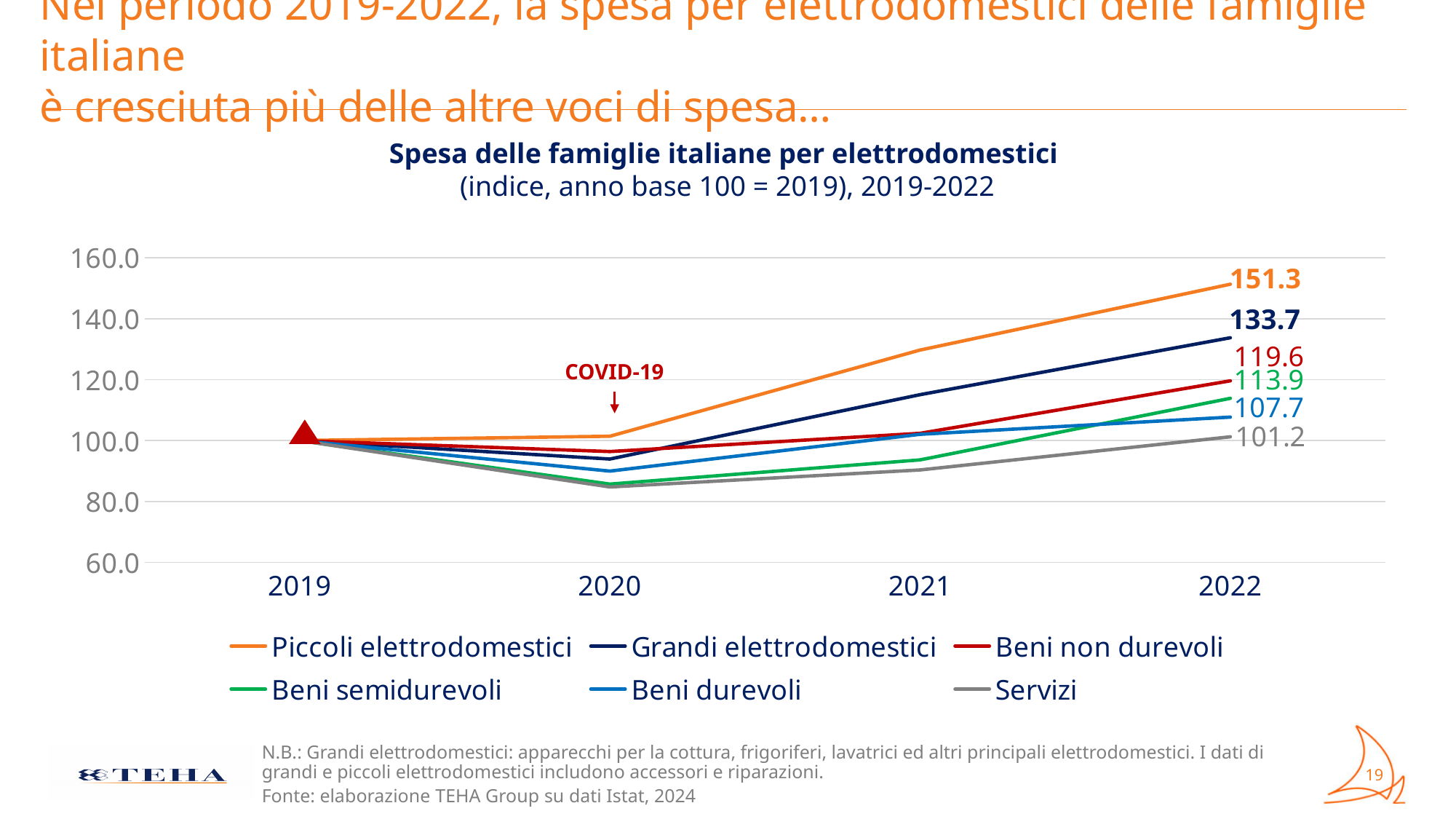
What is the index value for Grandi elettrodomestici in 2022? 133.7 What is the index value for Piccoli elettrodomestici in 2022? 151.3 How many series does the legend list? 6 Is the value for Beni semidurevoli in 2020 greater or less than 100? less What is the index value for Servizi in 2022? 101.2 Which series has the lowest value in 2022? Servizi What event is annotated with an arrow at 2020 on the chart? COVID-19 In 2022, which is larger: Beni non durevoli or Beni durevoli? Beni non durevoli Which series has the highest value in 2022? Piccoli elettrodomestici What is the difference between the 2022 values of Piccoli elettrodomestici and Grandi elettrodomestici? 17.6 How many years are shown on the x axis? 4 What type of chart is shown on the slide? line chart